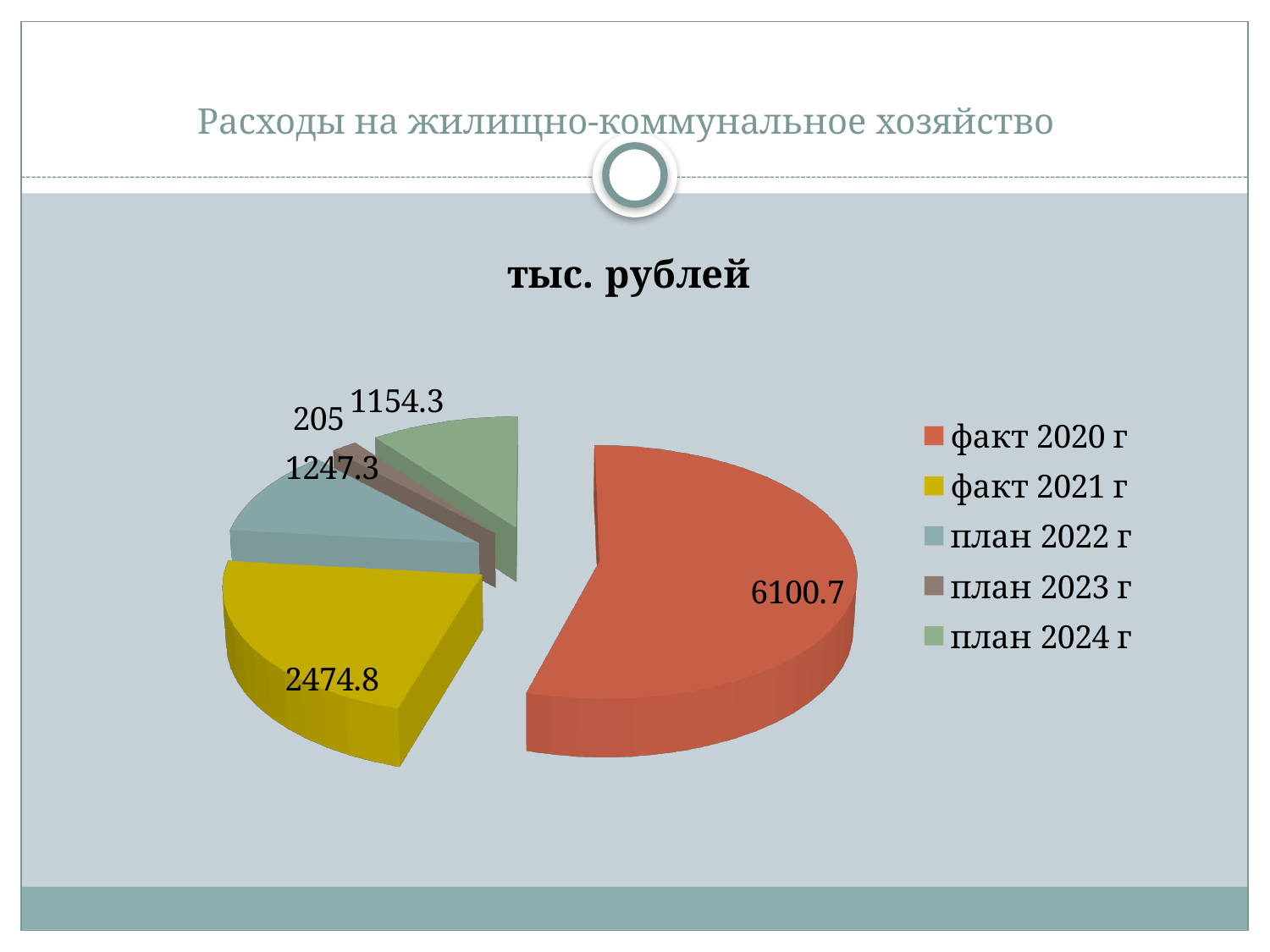
What is the value for факт 2020 г? 6100.7 What is the difference between the values for план 2022 г and план 2024 г? 93 What is the value for факт 2021 г? 2474.8 Which is larger, the value for план 2022 г or the value for план 2024 г? план 2022 г What is the value for план 2023 г? 205 How many slices does the pie chart have? 5 What kind of chart is shown on the slide? pie chart What is the title of the chart? тыс. рублей Which category has the largest slice of the pie? факт 2020 г What is the value for план 2024 г? 1154.3 Which category has the smallest slice of the pie? план 2023 г What is the difference between the values for факт 2020 г and факт 2021 г? 3625.9